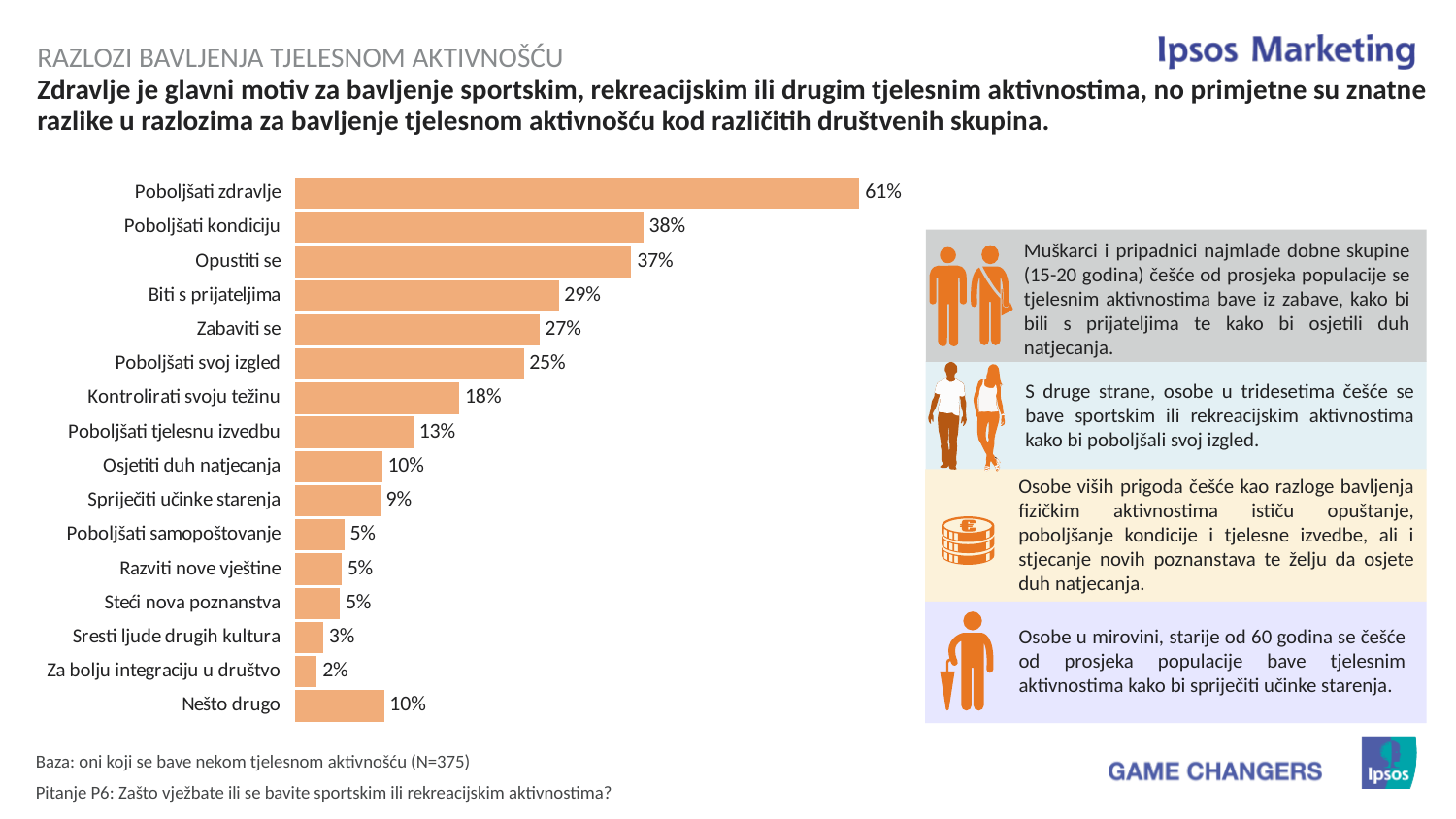
How many categories are shown in the chart? 16 What is the value for "Kontrolirati svoju težinu"? 18% Which is larger, the value for "Opustiti se" or the value for "Poboljšati svoj izgled"? Opustiti se What is the difference between the values for "Biti s prijateljima" and "Zabaviti se"? 2% What is the difference between the values for "Poboljšati zdravlje" and "Poboljšati kondiciju"? 23% What is the value for "Nešto drugo"? 10% What is the value for "Sresti ljude drugih kultura"? 3% Which category has the lowest value? Za bolju integraciju u društvo What is the title of the chart section on the slide? RAZLOZI BAVLJENJA TJELESNOM AKTIVNOŠĆU Which category has the highest value? Poboljšati zdravlje What kind of chart is shown on the slide? bar chart What is the value for "Poboljšati zdravlje"? 61%